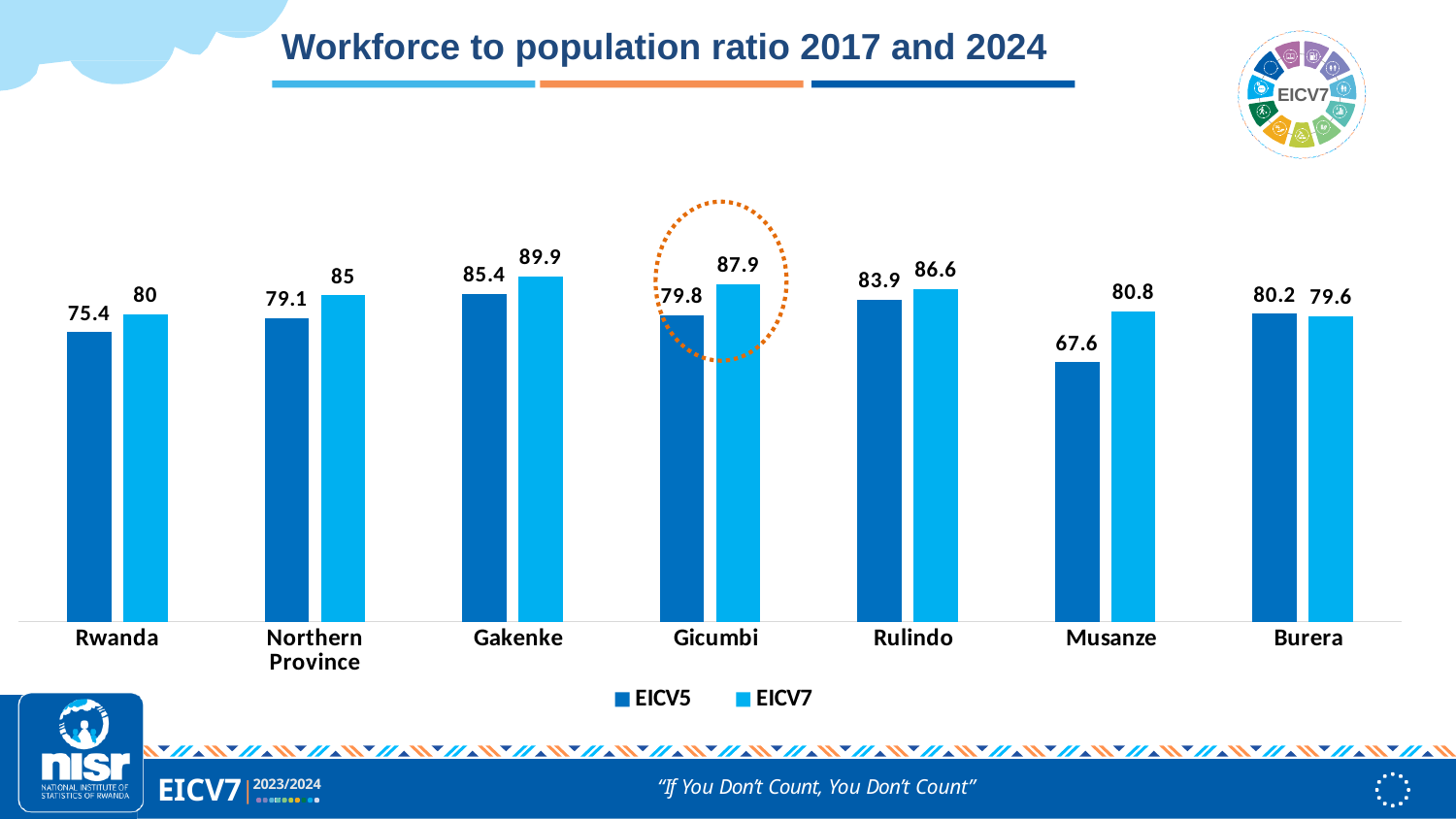
Which category has the highest EICV7 value? Gakenke How many categories are shown on the x axis? 7 Which category has the lowest EICV5 value? Musanze What kind of chart is shown on the slide? Bar chart What is the EICV5 value for Musanze? 67.6 How many series does the legend list? 2 Which is larger for Burera, the EICV5 value or the EICV7 value? EICV5 What is the EICV7 value for Rwanda? 80 What is the title of the chart? Workforce to population ratio 2017 and 2024 What is the EICV7 value for Gicumbi? 87.9 What is the difference between the EICV7 and EICV5 values for Musanze? 13.2 What is the difference between the EICV7 values for Gakenke and Rwanda? 9.9